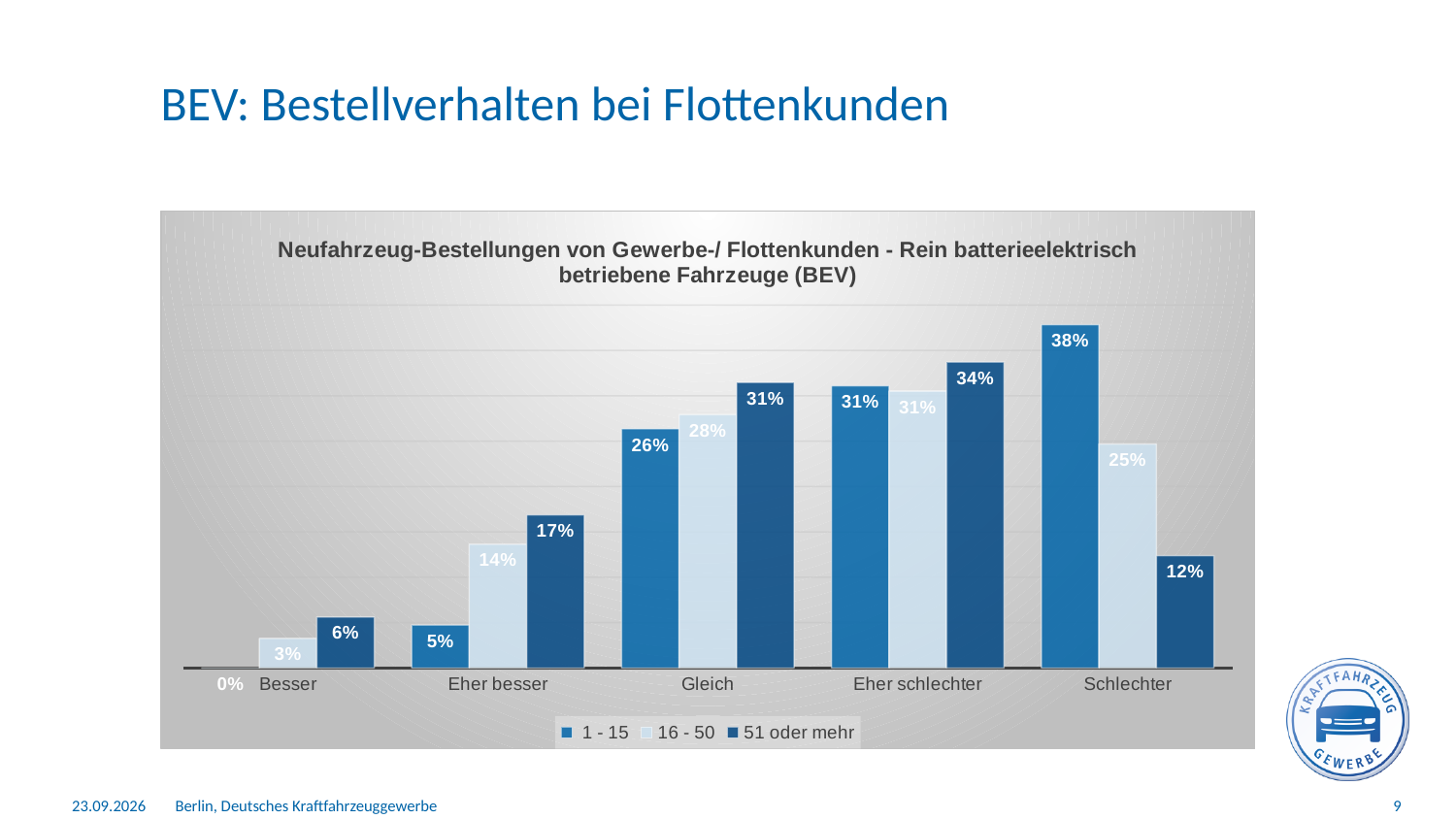
What is the value for '1 - 15' in the 'Schlechter' category? 38% Does the '1 - 15' series rise or fall from 'Besser' to 'Schlechter'? rise How many series does the legend list? 3 Which category has the lowest value for the '1 - 15' series? Besser In the 'Eher besser' category, which is larger: the value for '1 - 15' or for '51 oder mehr'? 51 oder mehr What kind of chart is shown on the slide? bar chart Which category has the highest value for the '51 oder mehr' series? Eher schlechter What is the value for '51 oder mehr' in the 'Gleich' category? 31% What is the title of the chart? Neufahrzeug-Bestellungen von Gewerbe-/ Flottenkunden - Rein batterieelektrisch betriebene Fahrzeuge (BEV) What is the difference between the '1 - 15' and '51 oder mehr' values in the 'Schlechter' category? 26% How many categories are shown on the x axis? 5 What is the value for '16 - 50' in the 'Eher besser' category? 14%